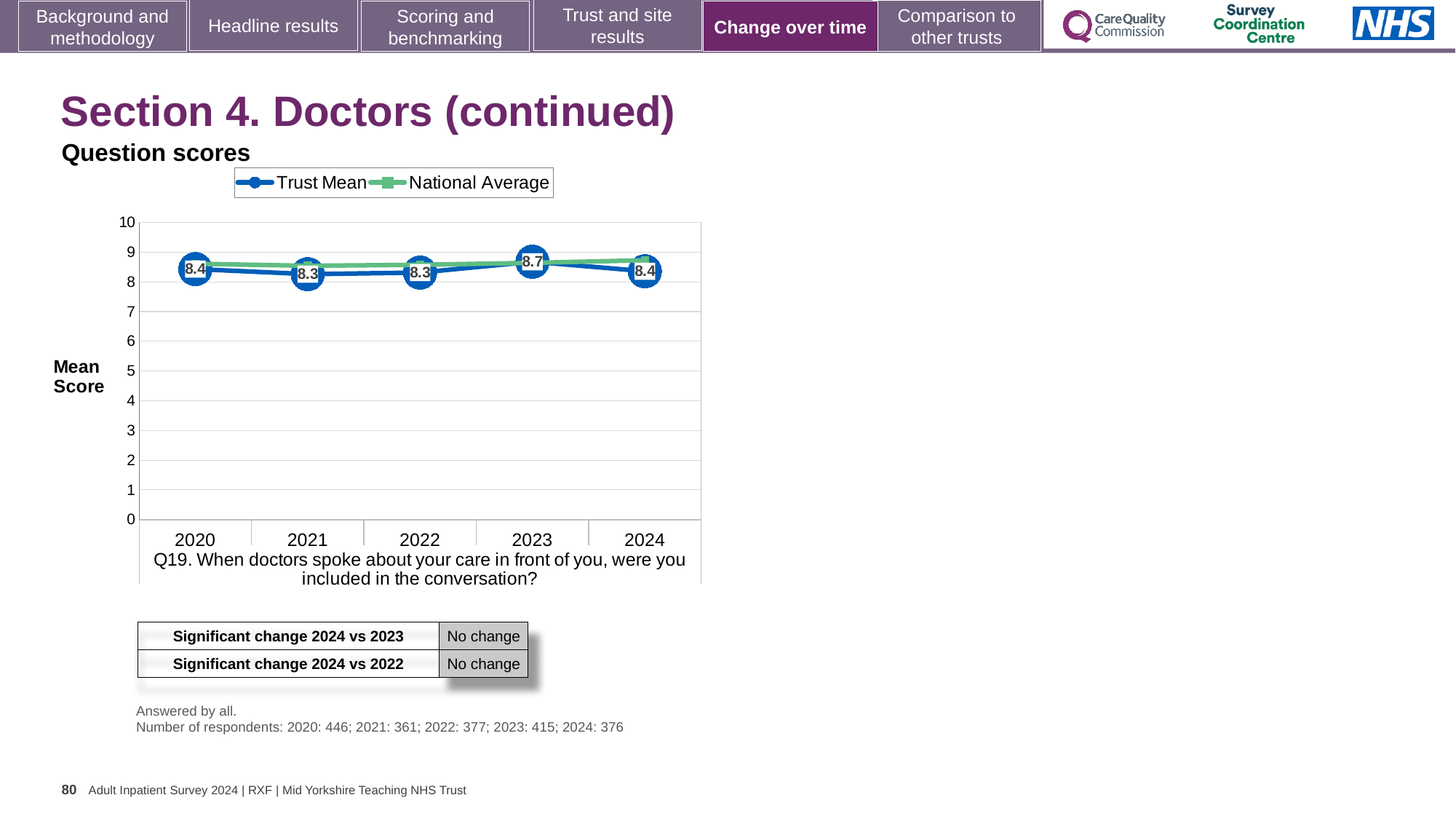
Does the Trust Mean rise or fall from 2022 to 2023? rise What is the label on the y axis of the chart? Mean Score What is the difference between the Trust Mean in 2023 and in 2024? 0.3 What is the Trust Mean score for 2020? 8.4 What kind of chart is shown? line chart How many years are plotted on the x axis? 5 What is the Trust Mean score for 2023? 8.7 In which year is the Trust Mean highest? 2023 How many series does the legend list? 2 What is the Trust Mean score for 2021? 8.3 Is the National Average value for 2020 greater or less than 8? greater Which year has the larger Trust Mean, 2021 or 2023? 2023